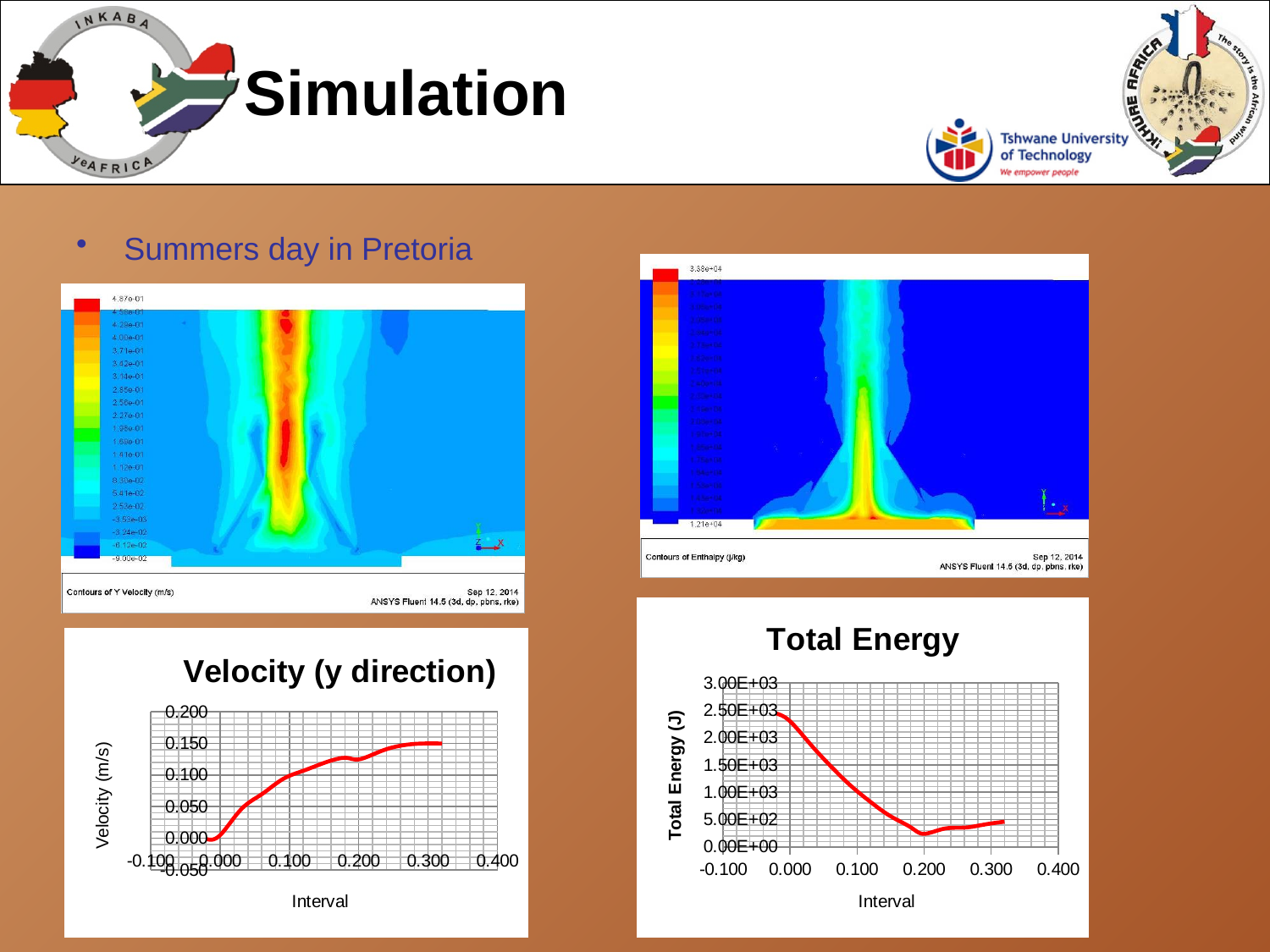
What kind of chart is the "Velocity (y direction)" chart? line chart In the "Velocity (y direction)" chart, is the value at interval 0.300 greater or less than 0.100? greater What is the y-axis title of the "Total Energy" chart? Total Energy (J) What kind of chart is the "Total Energy" chart? line chart In the "Total Energy" chart, do the values rise or fall as the interval increases from 0.000 to 0.200? fall In the "Velocity (y direction)" chart, do the values rise or fall as the interval increases from 0.000 to 0.300? rise In the "Total Energy" chart, is the value at interval 0.100 greater or less than 1.50E+03? less In the "Total Energy" chart, which is larger: the value at interval 0.000 or the value at interval 0.200? 0.000 In the "Total Energy" chart, is the value at interval 0.000 greater or less than 2.00E+03? greater In the "Velocity (y direction)" chart, which is larger: the value at interval 0.100 or the value at interval 0.300? 0.300